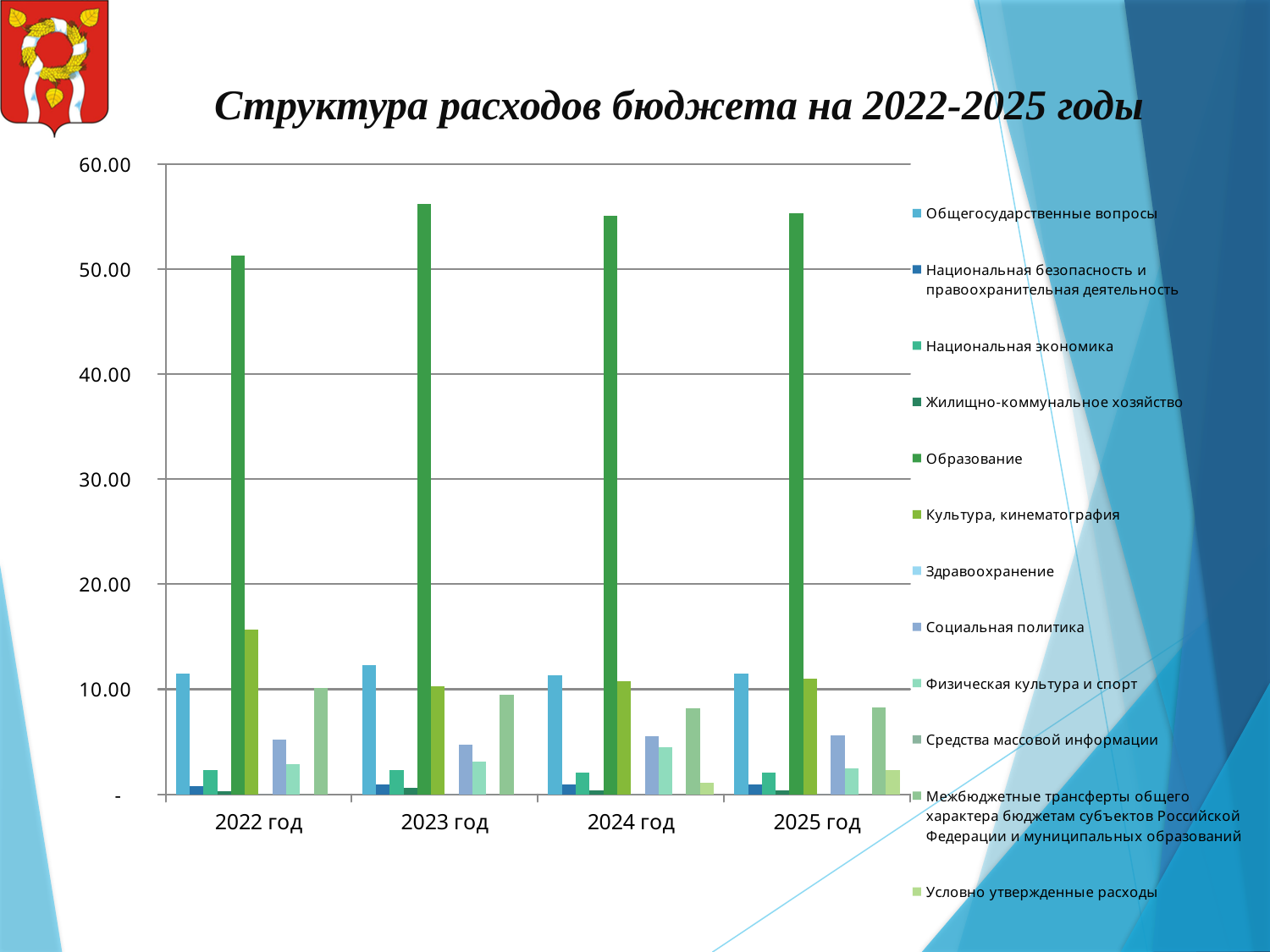
What kind of chart is shown on the slide? bar chart Is the value for Культура, кинематография in 2022 год greater or less than 10? greater Is the value for Образование in 2023 год greater or less than 50? greater Is the value for Социальная политика in 2022 год greater or less than 10? less What is the title of the chart? Структура расходов бюджета на 2022-2025 годы Which is larger: the value for Образование in 2022 год or in 2023 год? 2023 год How many year categories are shown on the x axis? 4 Which series has the highest value in 2023 год? Образование Which series has the highest value in 2025 год? Образование How many series does the legend list? 12 Which is larger: the value for Культура, кинематография in 2022 год or in 2023 год? 2022 год